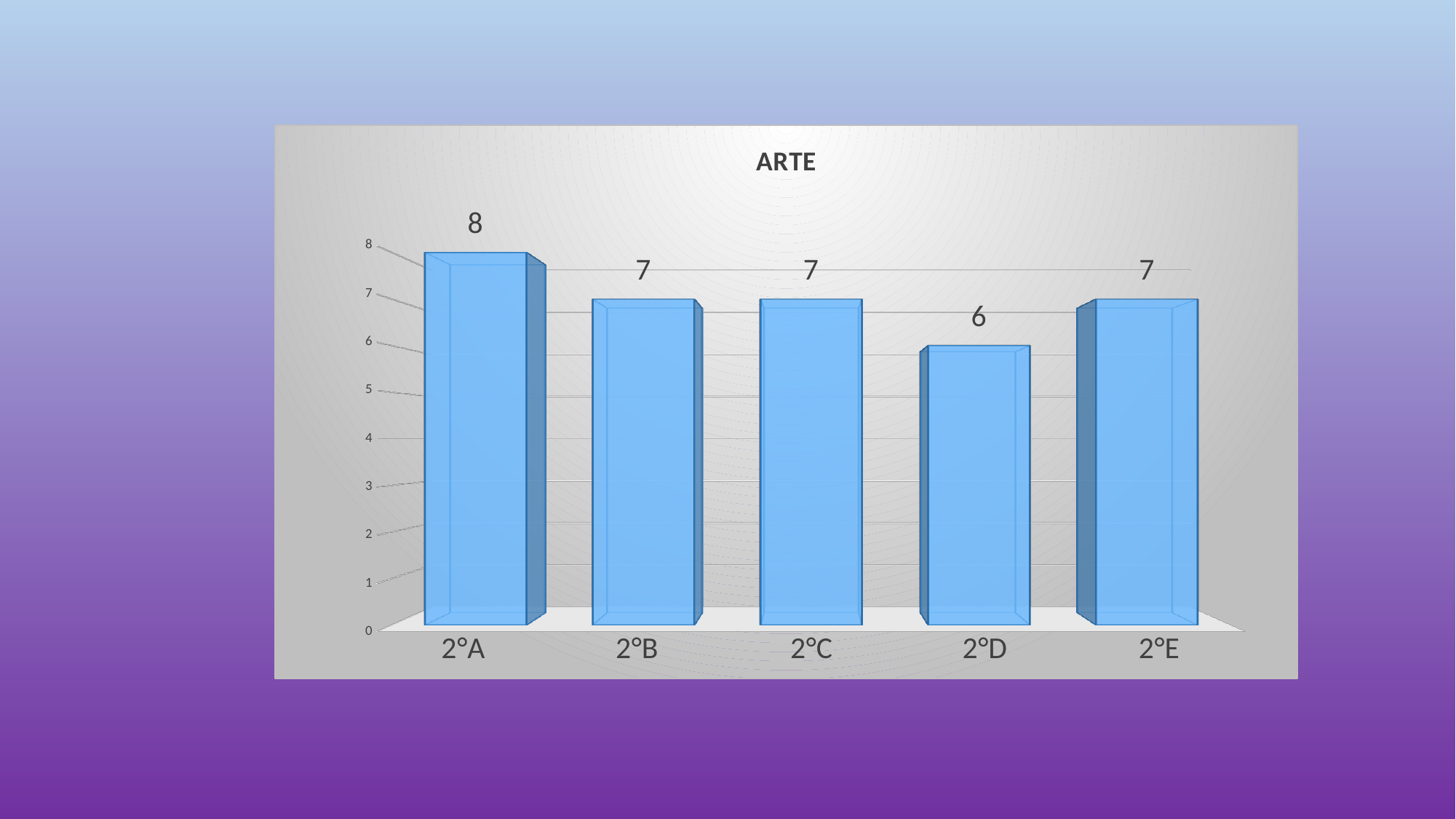
What is the difference between the values for 2°A and 2°B? 1 Is the value for 2°D greater or less than 7? less What is the title of the chart? ARTE What is the value for 2°D? 6 Which category has the lowest value? 2°D How many categories are shown on the x axis? 5 What is the value for 2°E? 7 What is the value for 2°A? 8 Which category has the highest value? 2°A What kind of chart is shown? bar chart Which is larger, the value for 2°B or the value for 2°D? 2°B What is the difference between the values for 2°A and 2°D? 2